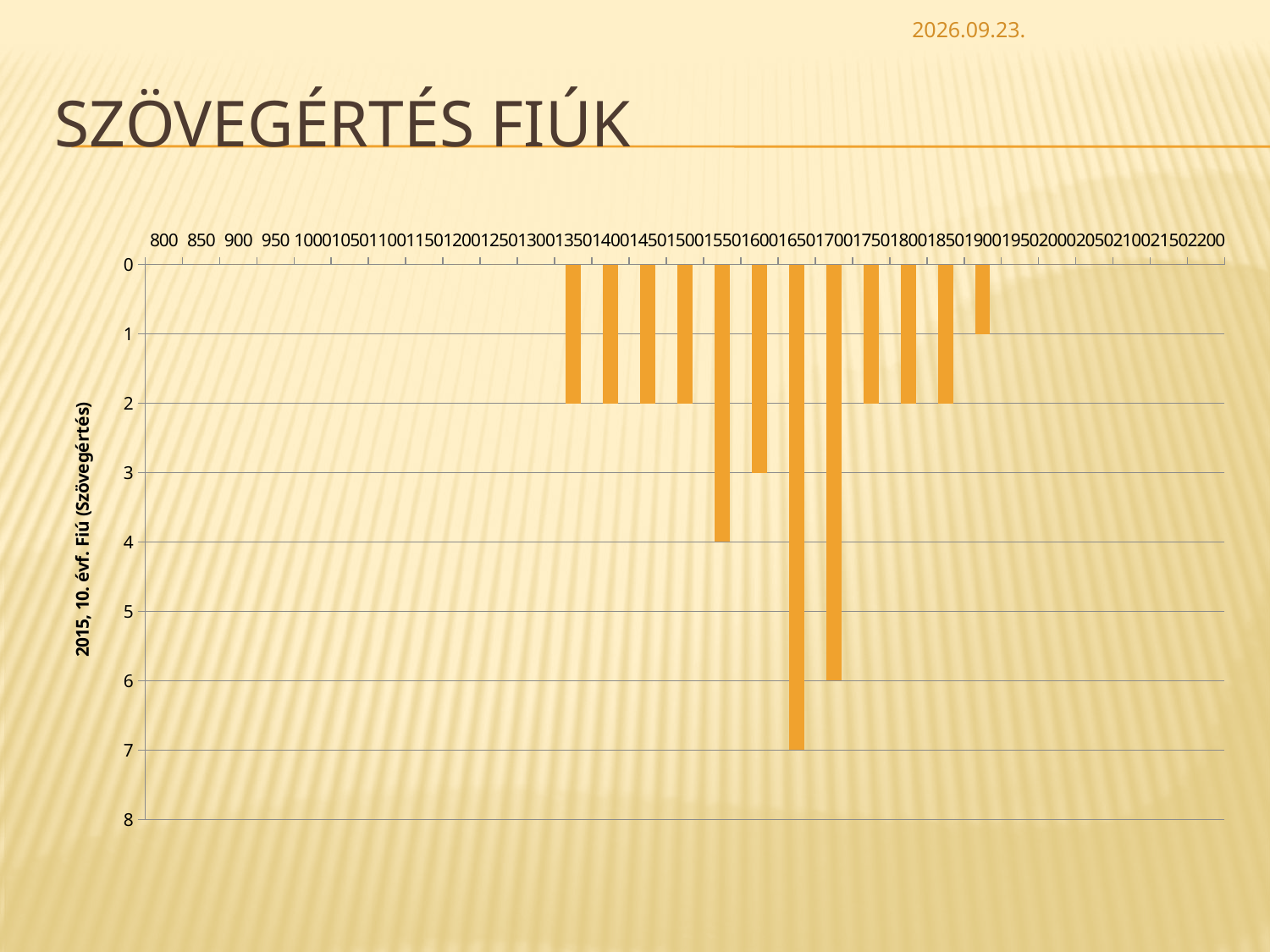
How many bars are plotted in the chart? 12 What is the title of the slide? SZÖVEGÉRTÉS FIÚK What is the value of the bar at 1700? 6 Which x-axis category has the lowest non-zero bar? 1900 What is the label on the vertical axis? 2015, 10. évf. Fiú (Szövegértés) Which x-axis category has the highest bar? 1650 What is the value of the bar at 1900? 1 What kind of chart is shown on the slide? bar chart What is the difference between the bars at 1650 and 1700? 1 What is the value of the bar at 1650? 7 Which is larger, the bar at 1550 or the bar at 1600? 1550 What is the value of the bar at 1550? 4